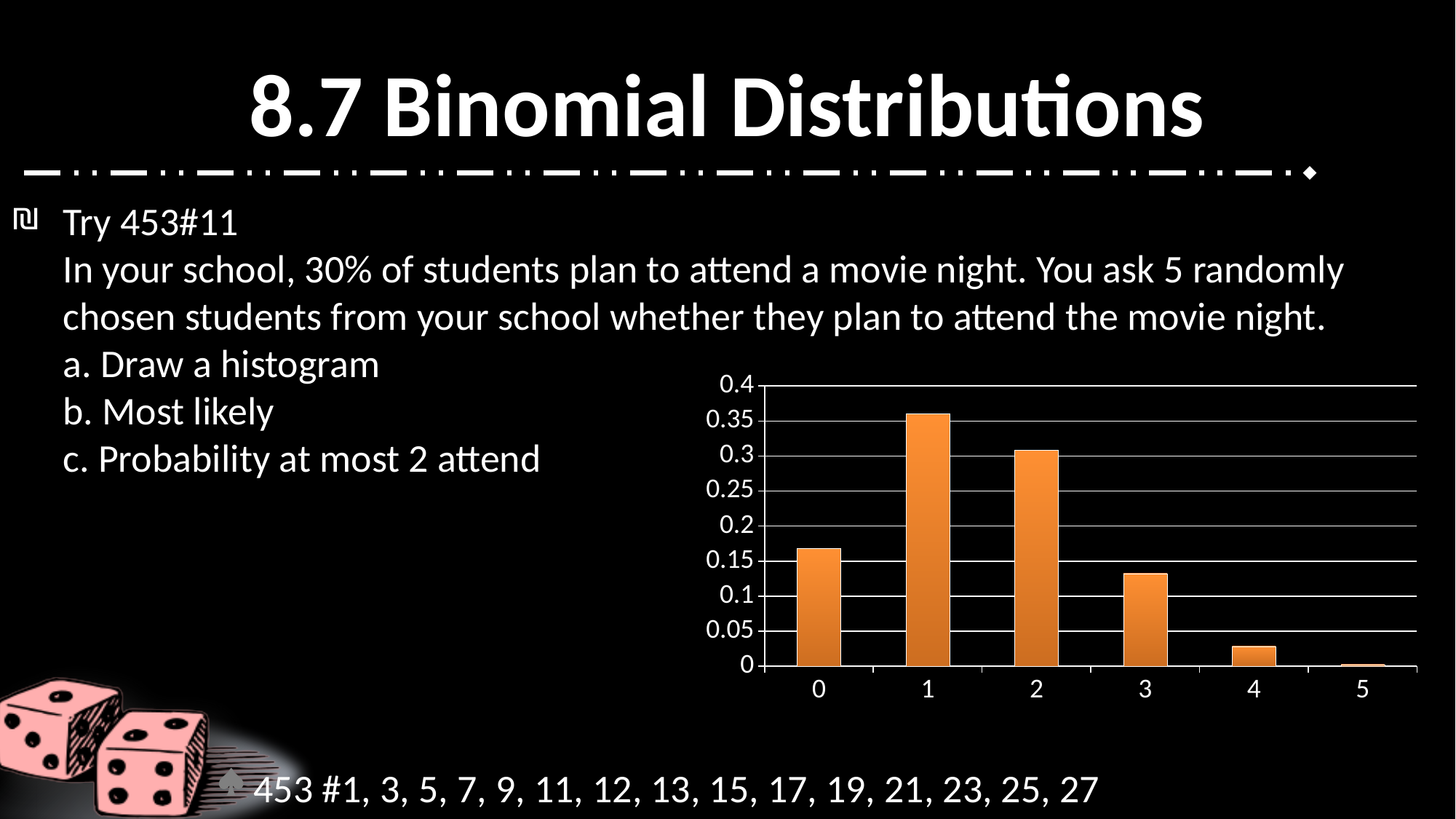
Is the value for category 2 greater or less than 0.35? less Is the value for category 3 greater or less than 0.15? less Which category has the lowest bar in the chart? 5 How many categories are shown on the x axis of the chart? 6 Is the value for category 4 greater or less than 0.05? less Which has the larger value, category 0 or category 3? 0 Which has the larger value, category 1 or category 2? 1 What kind of chart is shown on the slide? bar chart Do the bar values rise or fall from category 1 to category 5? fall Which category has the highest bar in the chart? 1